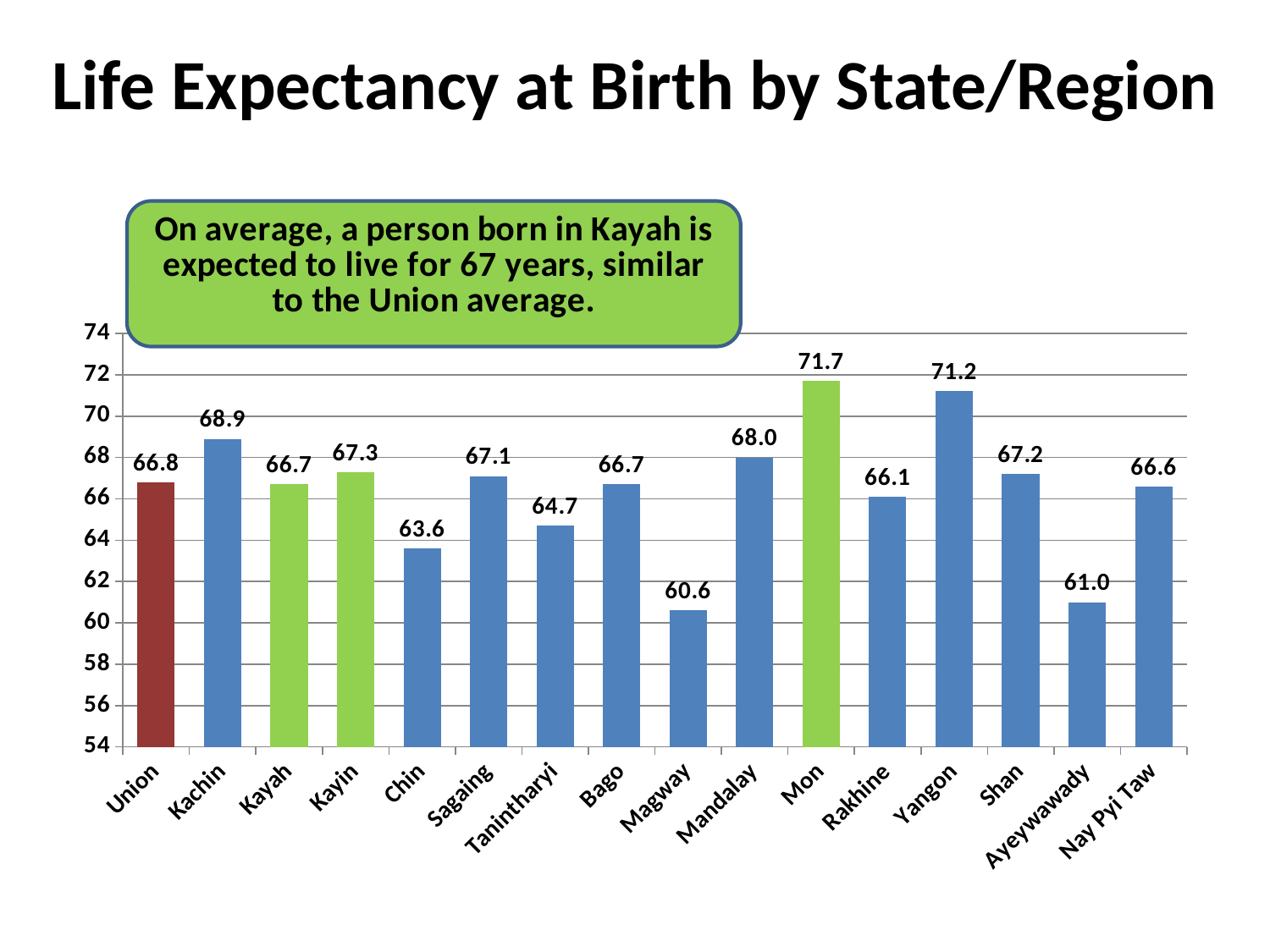
What is the life expectancy at birth for Magway? 60.6 What colour is the bar for the Union? Red What is the difference in life expectancy between Kayin and Kayah? 0.6 How many bars are shown in the chart? 16 What is the life expectancy at birth for Kayah? 66.7 What is the life expectancy at birth for the Union? 66.8 Is the life expectancy for Chin greater or less than 64? less What type of chart is shown on the slide? Bar chart Which has a higher life expectancy at birth, Yangon or Mandalay? Yangon Which state/region has the lowest life expectancy at birth? Magway Which state/region has the highest life expectancy at birth? Mon What is the difference in life expectancy between Mon and Magway? 11.1